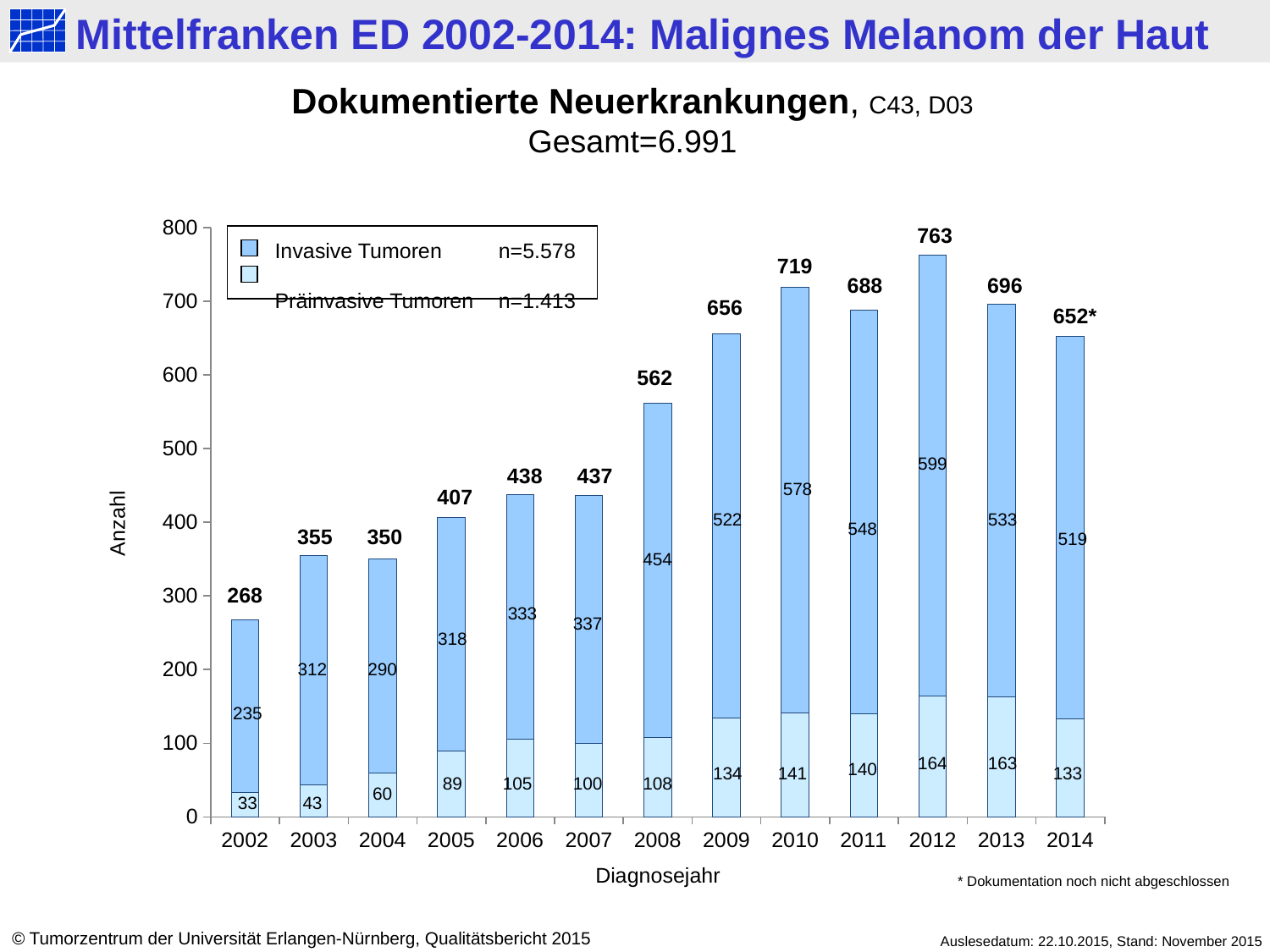
What is the total of the stacked bar for 2006? 438 Is the total for 2008 greater or less than 500? greater What kind of chart is shown on the slide? Stacked bar chart What is the difference between the total for 2012 and the total for 2013? 67 Which year has the highest total number of documented new cases? 2012 What is the n value given in the legend for Präinvasive Tumoren? n=1.413 What is the number of Präinvasive Tumoren in 2005? 89 How many years are shown on the x axis? 13 How many series does the legend list? 2 What is the number of Invasive Tumoren in 2010? 578 Which is larger, the number of Invasive Tumoren in 2009 or in 2011? 2011 Which year has the lowest total number of documented new cases? 2002